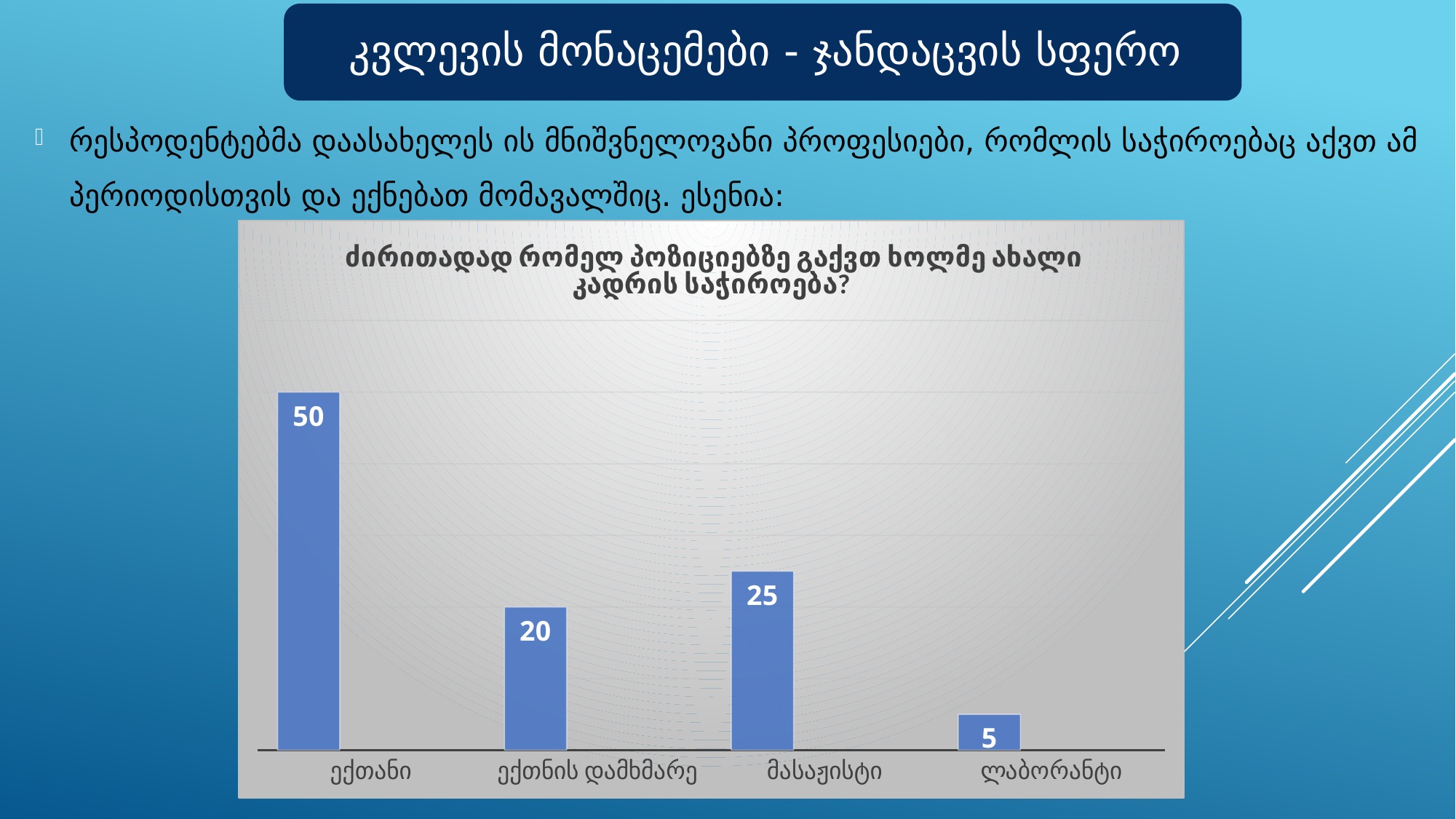
What is the difference between the values for ექთნის დამხმარე and ლაბორანტი? 15 What kind of chart is shown on the slide? bar chart Which is larger, the value for ექთნის დამხმარე or the value for მასაჟისტი? მასაჟისტი What is the value for ექთნის დამხმარე? 20 What is the title of the chart? ძირითადად რომელ პოზიციებზე გაქვთ ხოლმე ახალი კადრის საჭიროება? How many categories are shown in the chart? 4 Which category has the lowest value? ლაბორანტი Which category has the highest value? ექთანი What is the difference between the values for ექთანი and მასაჟისტი? 25 What is the value for ექთანი? 50 What is the value for ლაბორანტი? 5 What is the value for მასაჟისტი? 25